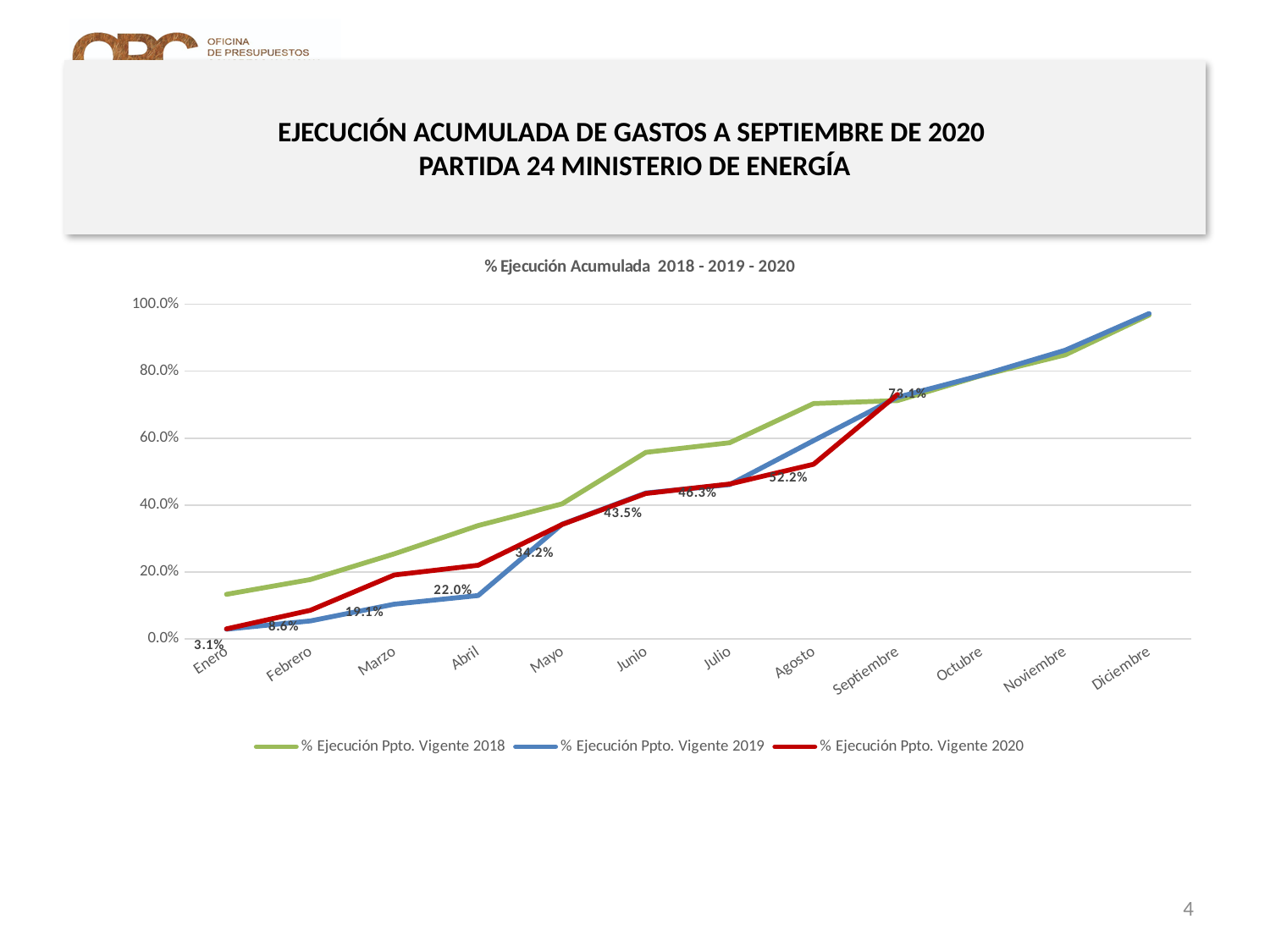
Do the values of the 2020 series rise or fall from Enero to Septiembre? rise What is the value for % Ejecución Ppto. Vigente 2020 in Enero? 3.1% What is the difference between the 2020 values for Junio and Mayo? 9.3% What kind of chart is shown on the slide? line chart What is the value for % Ejecución Ppto. Vigente 2020 in Agosto? 52.2% In Junio, which series is higher: % Ejecución Ppto. Vigente 2018 or % Ejecución Ppto. Vigente 2019? % Ejecución Ppto. Vigente 2018 How many series does the legend list? 3 How many months are shown along the x axis? 12 What is the value for % Ejecución Ppto. Vigente 2020 in Mayo? 34.2% What is the difference between the 2020 values for Agosto and Julio? 5.9% Is the value for % Ejecución Ppto. Vigente 2018 in Junio greater or less than 40.0%? greater What is the value for % Ejecución Ppto. Vigente 2020 in Abril? 22.0%